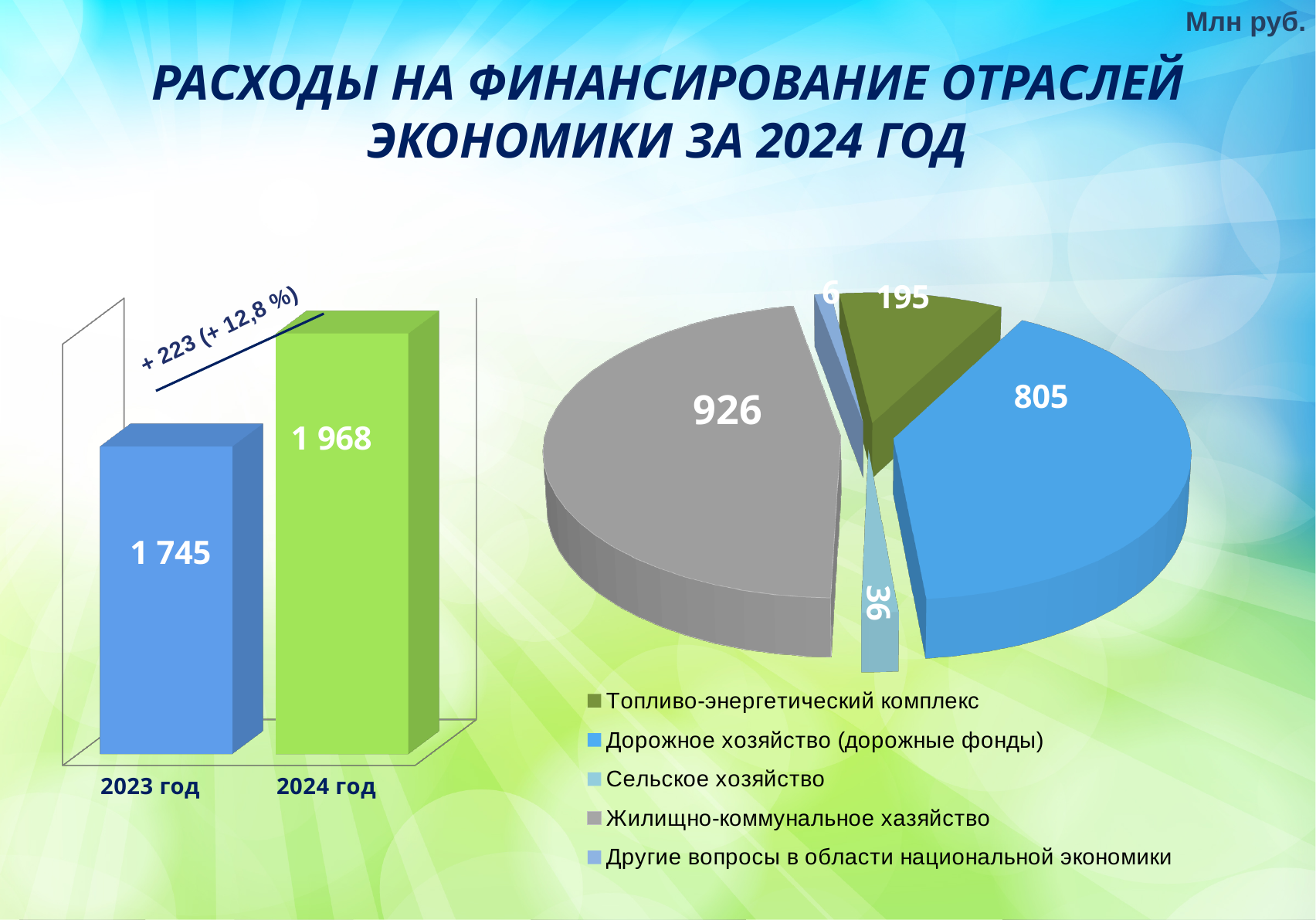
What kind of chart is the chart on the left of the slide? Bar chart On the pie chart on the right, what is the difference between the values for Жилищно-коммунальное хазяйство and Дорожное хозяйство (дорожные фонды)? 121 On the pie chart on the right, what is the value for Дорожное хозяйство (дорожные фонды)? 805 On the bar chart on the left, what is the value for 2023 год? 1 745 How many entries does the legend of the pie chart on the right list? 5 How many categories does the bar chart on the left show? 2 On the pie chart on the right, which category has the smallest value? Другие вопросы в области национальной экономики On the pie chart on the right, which category has the largest value? Жилищно-коммунальное хазяйство On the bar chart on the left, which year has the larger value, 2023 год or 2024 год? 2024 год On the pie chart on the right, what is the value for Сельское хозяйство? 36 On the bar chart on the left, what is the value for 2024 год? 1 968 On the bar chart on the left, what is the difference between the 2024 год and 2023 год values? 223